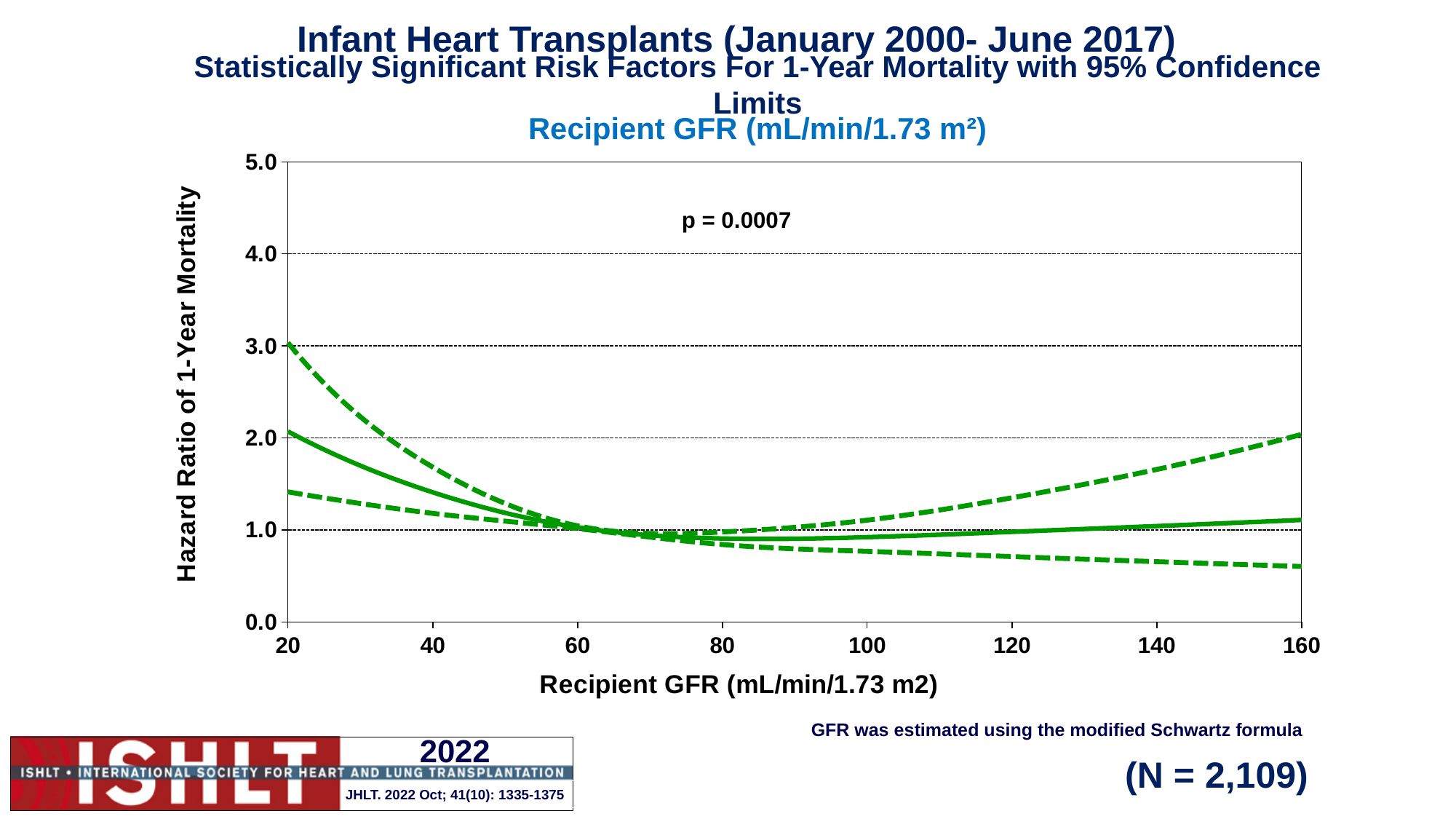
Is the lower confidence limit (lower dashed line) at a Recipient GFR of 20 greater or less than 1.0? greater Does the solid hazard ratio line rise or fall as Recipient GFR increases from 20 to 60? fall What p-value is printed on the chart? p = 0.0007 Is the solid hazard ratio line at a Recipient GFR of 40 greater or less than 1.0? greater Is the upper confidence limit (upper dashed line) at a Recipient GFR of 30 greater or less than 2.0? greater At which end of the x axis, 20 or 160, is the solid hazard ratio line higher? 20 How many lines are plotted on the chart? 3 What is the sample size (N) shown on the slide? N = 2,109 What kind of chart is shown on the slide? line chart